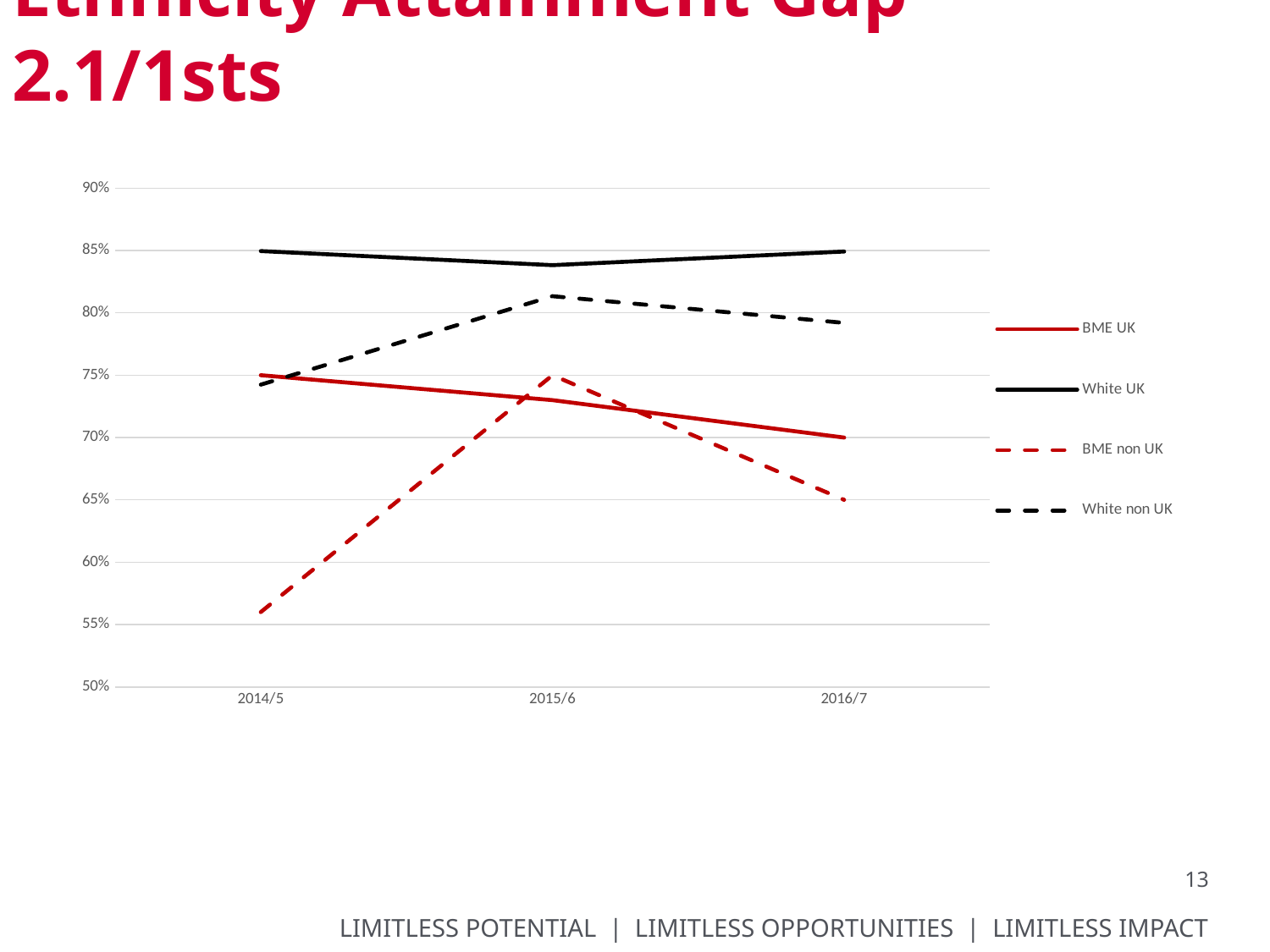
In 2016/7, which is larger: BME UK or BME non UK? BME UK Is the value for White UK in 2015/6 greater or less than 80%? greater Which series has the lowest value in 2014/5? BME non UK Is the value for White non UK in 2015/6 greater or less than 80%? greater What kind of chart is shown on the slide? line chart Which series has the highest value in 2014/5? White UK Which series is drawn as a red dashed line in the legend? BME non UK How many academic years are shown on the x axis? 3 How many series does the legend list? 4 Does the BME UK line rise or fall from 2014/5 to 2016/7? fall Is the value for BME non UK in 2014/5 greater or less than 60%? less